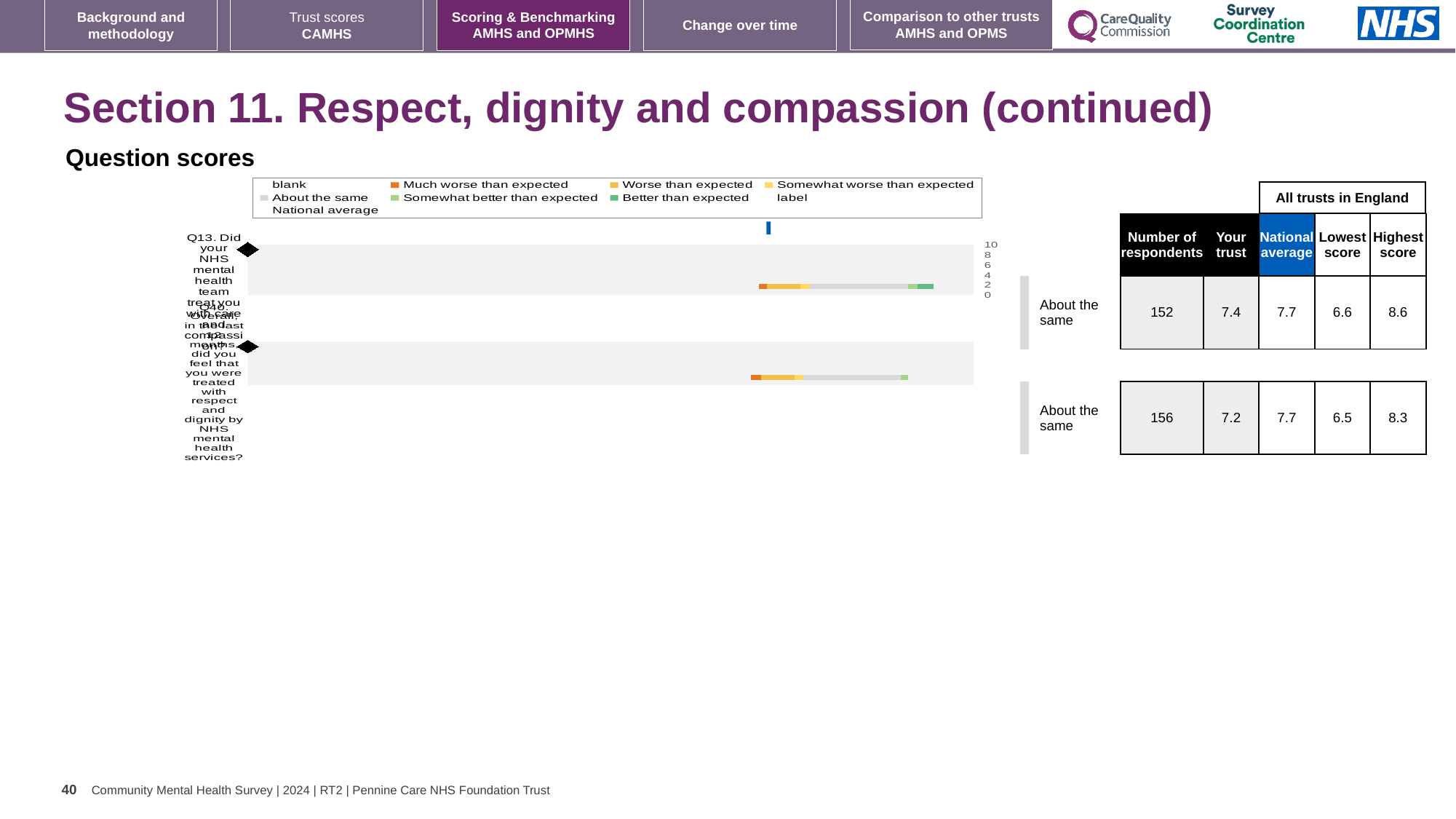
Which question has the higher 'Your trust' score, Q13 or Q10? Q13 What is the highest score across all trusts in England for Q13? 8.6 How many entries does the chart legend list? 9 What is the national average score for Q13 shown in the table? 7.7 What is the difference between the highest and lowest scores for Q10? 1.8 What kind of chart is shown under 'Question scores'? bar chart How many respondents answered Q10? 156 How many question categories are plotted on the chart? 2 What is the highest tick value shown on the chart's axis? 10 What is the lowest score across all trusts in England for Q10? 6.5 According to the table beside the chart, what is the 'Your trust' score for Q10? 7.2 According to the table beside the chart, what is the 'Your trust' score for Q13? 7.4